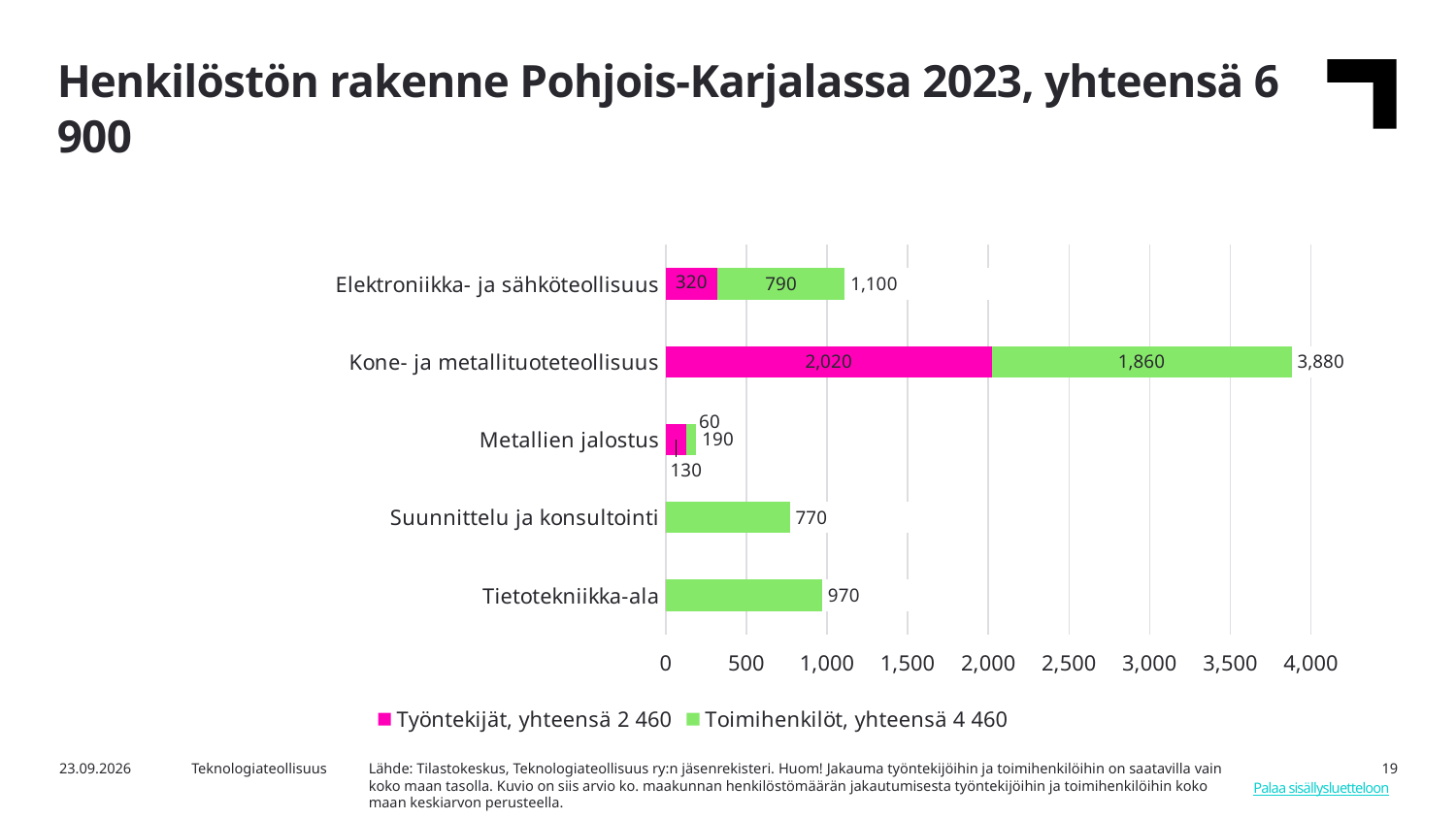
Which category has the highest total? Kone- ja metallituoteteollisuus What is the Toimihenkilöt value for Tietotekniikka-ala? 970 How many series does the legend list? 2 What is the difference between the Toimihenkilöt values for Tietotekniikka-ala and Suunnittelu ja konsultointi? 200 Which is larger: the Työntekijät value or the Toimihenkilöt value for Elektroniikka- ja sähköteollisuus? Toimihenkilöt How many categories are shown on the chart? 5 What is the total of the stacked bar for Metallien jalostus? 190 What is the Työntekijät value for Kone- ja metallituoteteollisuus? 2,020 What kind of chart is shown on the slide? Stacked bar chart What is the total of the stacked bar for Kone- ja metallituoteteollisuus? 3,880 What is the Toimihenkilöt value for Elektroniikka- ja sähköteollisuus? 790 Which category has the lowest total? Metallien jalostus